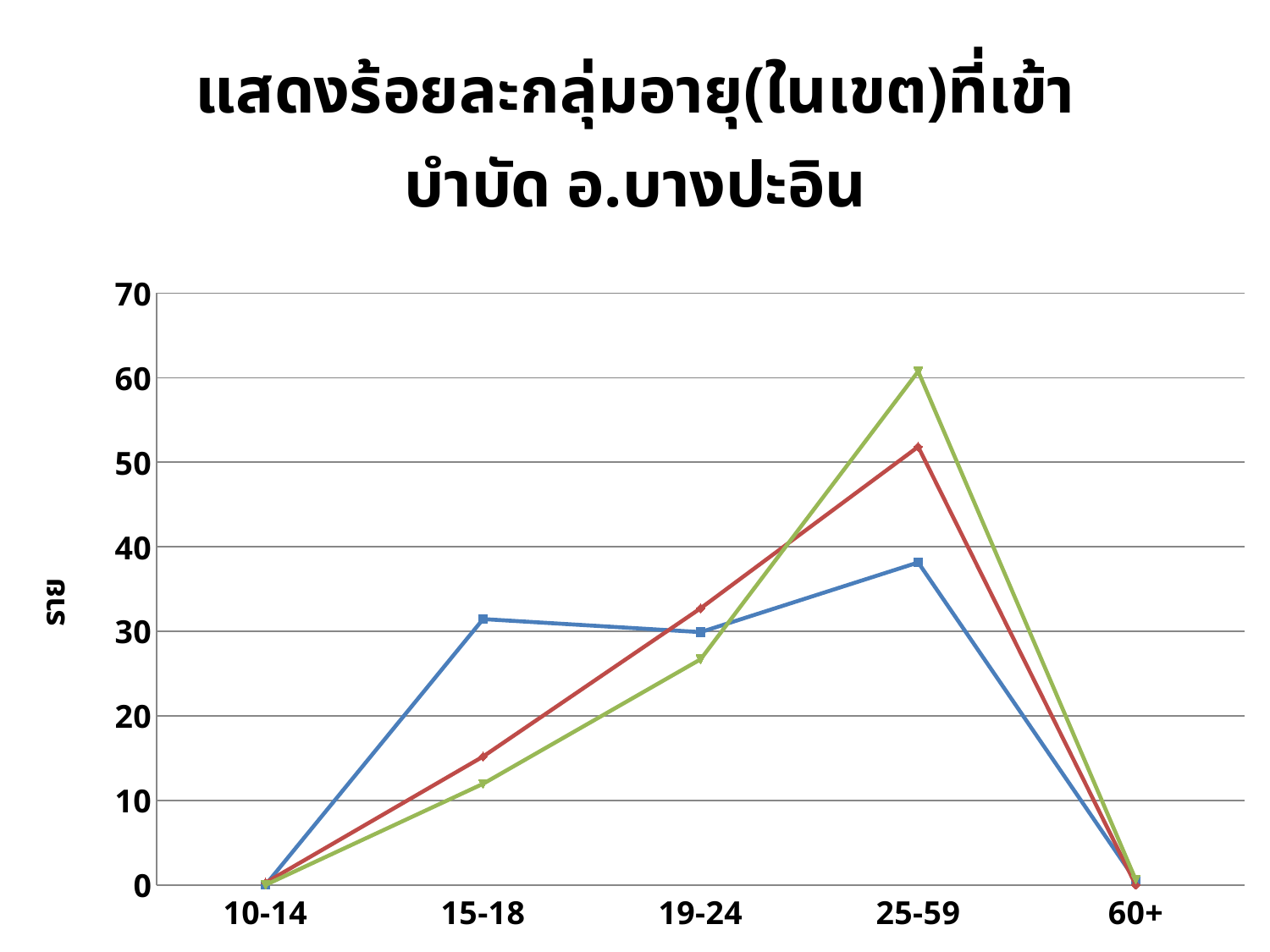
Is the value of the blue line for 15-18 greater or less than 20? greater For the blue line, which age group has the highest value? 25-59 Is the value of the red line for 25-59 greater or less than 40? greater What kind of chart is shown on the slide? line chart How many lines are plotted on the chart? 3 Do the lines rise or fall from 25-59 to 60+? fall For the green line, which age group has the highest value? 25-59 Is the value of the green line for 25-59 greater or less than 50? greater How many age-group categories are shown on the x axis? 5 At 25-59, which line has the larger value, the green line or the blue line? green line At 15-18, which line has the larger value, the blue line or the red line? blue line